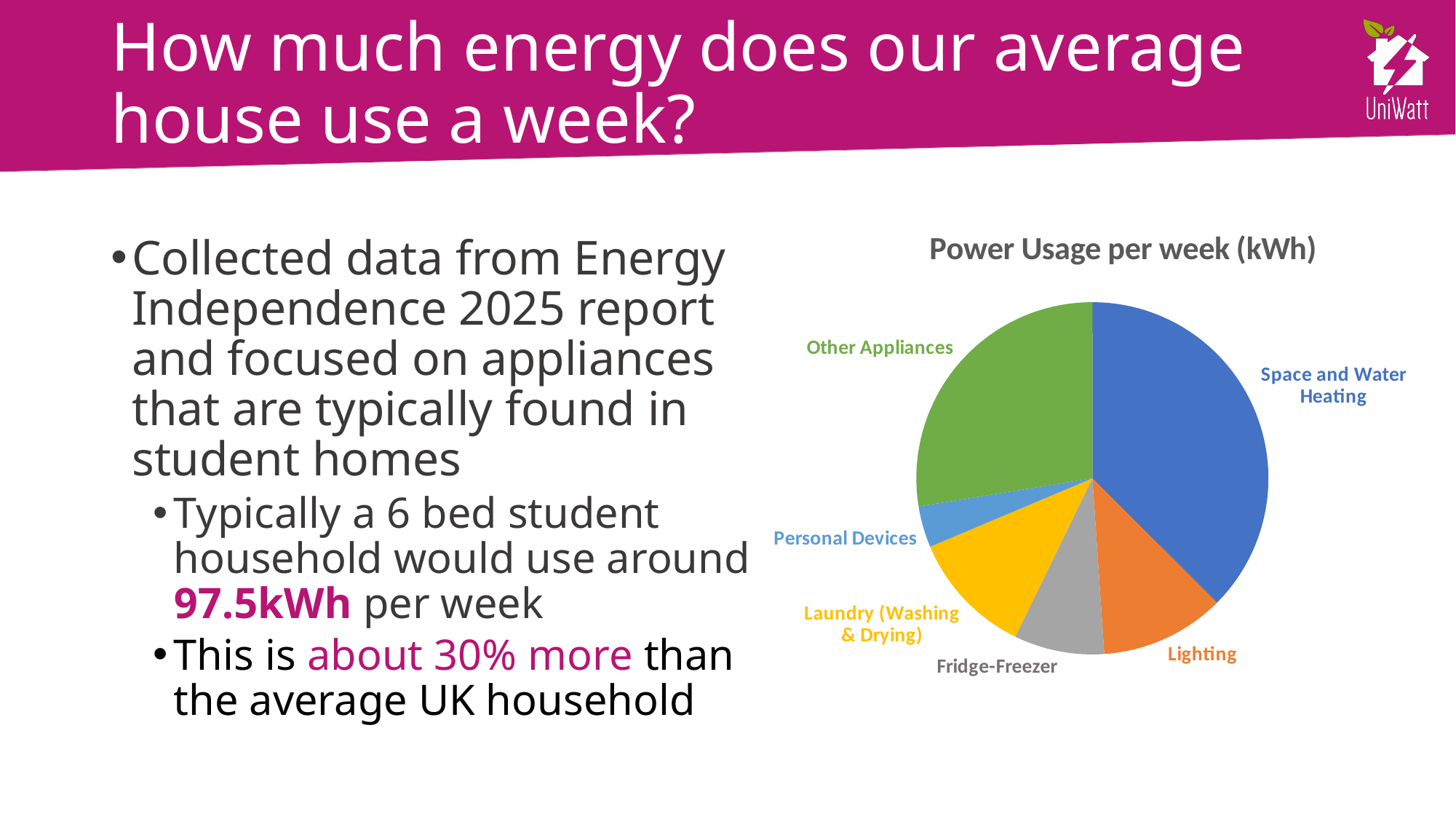
Which slice is larger, Laundry (Washing & Drying) or Personal Devices? Laundry (Washing & Drying) How many categories (slices) does the pie chart have? 6 Which slice is larger, Fridge-Freezer or Personal Devices? Fridge-Freezer What colour is the Space and Water Heating slice in the pie chart? blue Which slice is larger, Space and Water Heating or Other Appliances? Space and Water Heating Which category has the largest slice of the pie chart? Space and Water Heating Which category has the smallest slice of the pie chart? Personal Devices What is the title of the chart? Power Usage per week (kWh) What kind of chart is shown on the slide? pie chart